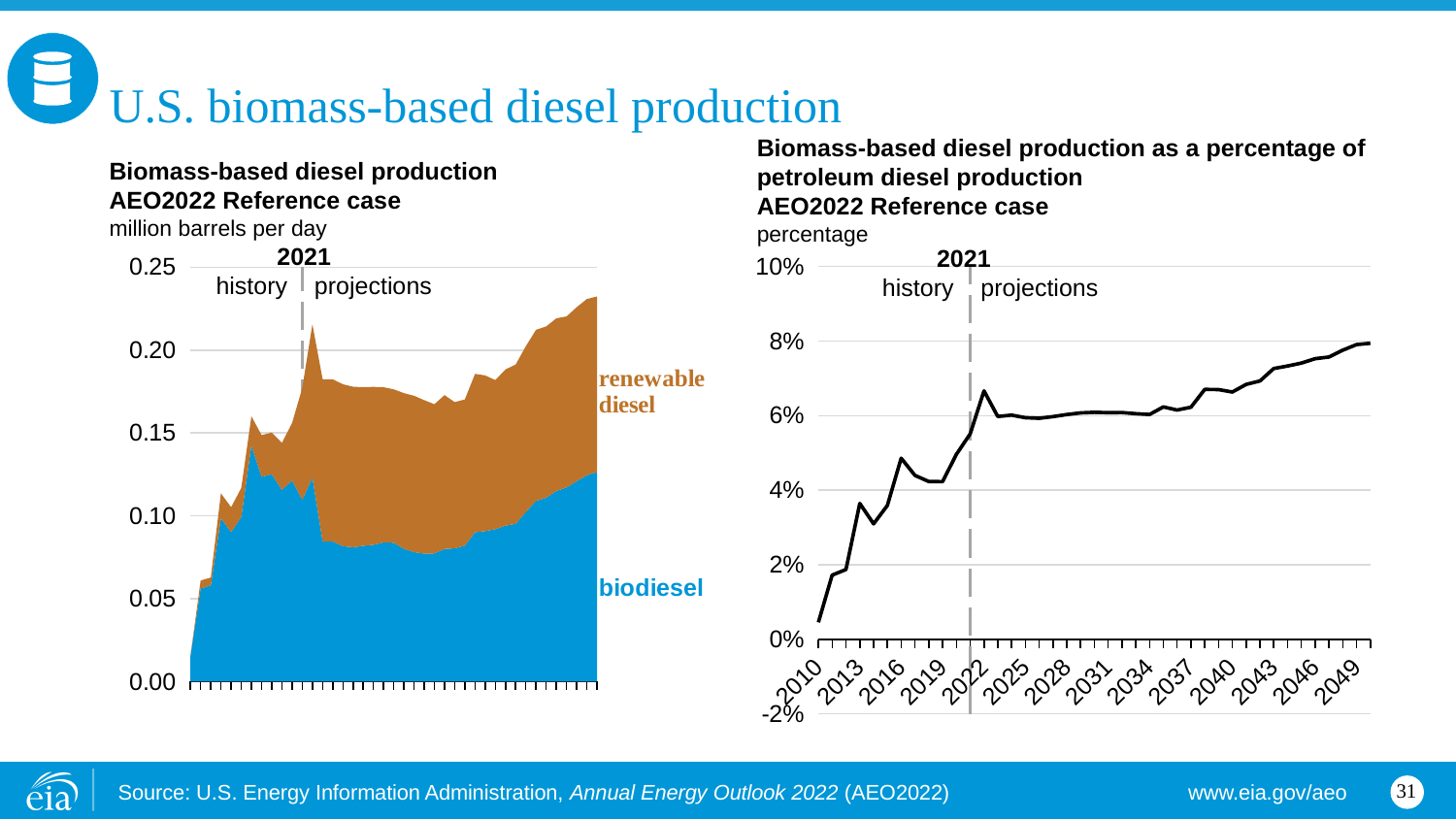
In the left chart, which two series are labelled? renewable diesel and biodiesel In the right chart, does the percentage rise or fall from 2030 to 2049? rise What kind of chart is the left chart, 'Biomass-based diesel production'? stacked area chart In the right chart, which year does the dashed vertical line separating history from projections mark? 2021 In the left chart, does total biomass-based diesel production generally rise or fall over the projection period? rise In the left chart, is the total biomass-based diesel production at the end of the projection period greater or less than 0.20 million barrels per day? greater What kind of chart is the right chart, 'Biomass-based diesel production as a percentage of petroleum diesel production'? line chart In the right chart, is the value for 2010 greater or less than 2%? less In the left chart, what unit is used on the y axis? million barrels per day In the left chart, is biodiesel production at the end of the projection period greater or less than 0.10 million barrels per day? greater In the left chart, how many series are shown? 2